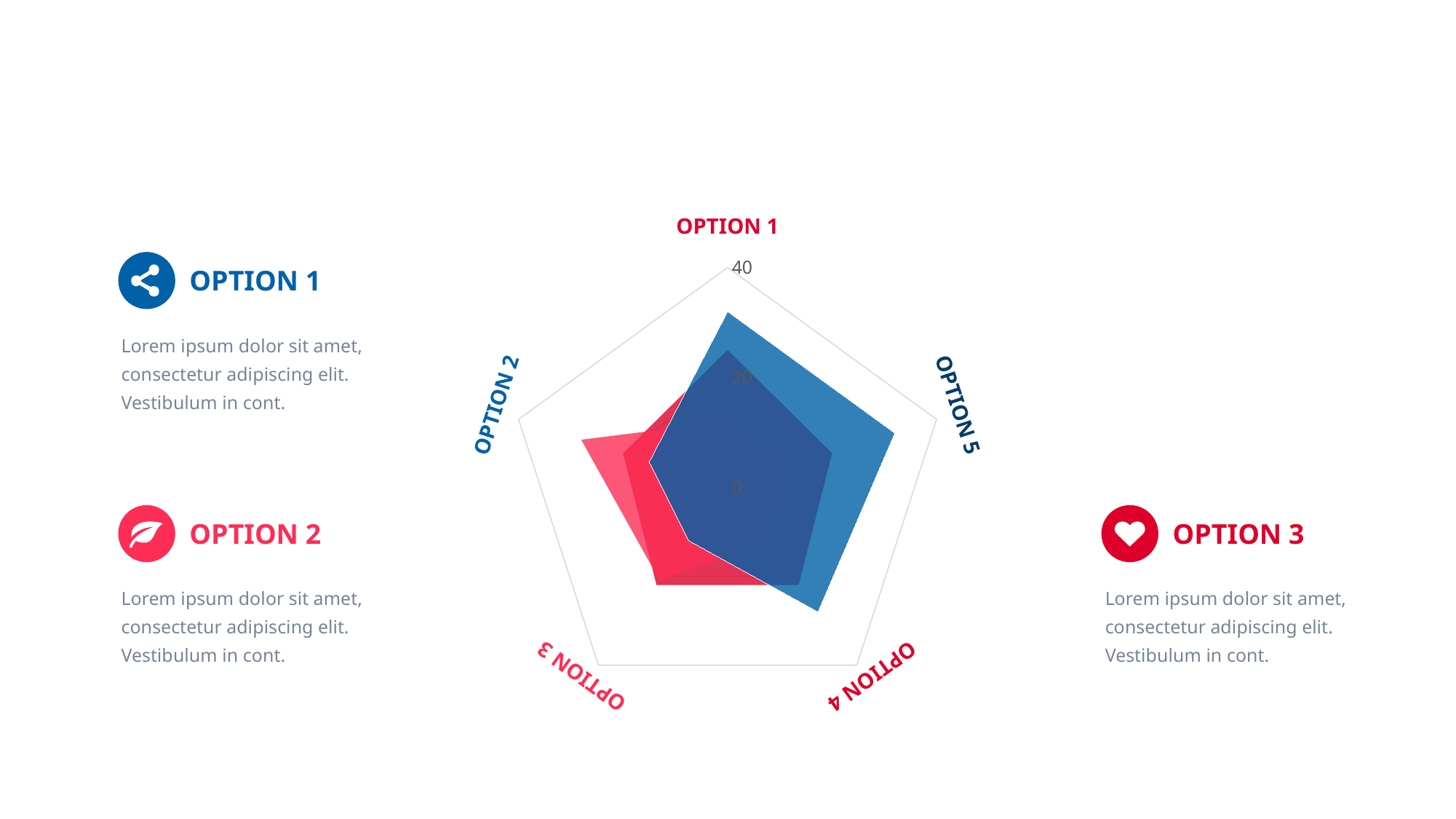
For OPTION 1, which series has the larger value, blue or red? blue Is the blue series' value for OPTION 5 greater or less than 20? greater Is the blue series' value for OPTION 2 greater or less than 20? less For which category does the red series reach its highest value? OPTION 2 What kind of chart is shown on the slide? radar chart How many categories (axes) does the radar chart have? 5 What is the highest value shown on the radar chart's axis scale? 40 For OPTION 2, which series has the larger value, blue or red? red How many data series are plotted on the radar chart? 3 Is the blue series' value for OPTION 1 greater or less than 20? greater